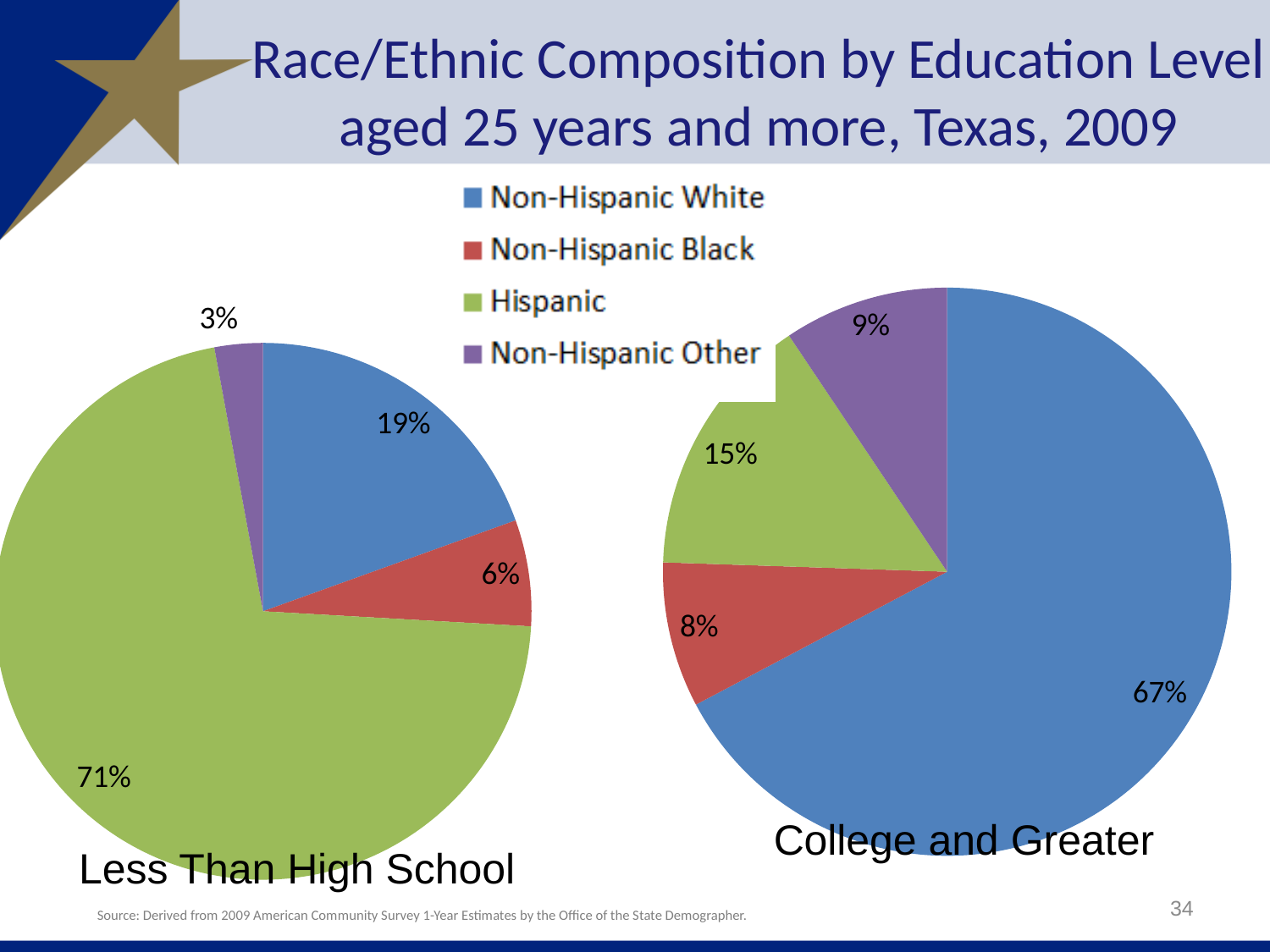
In the Less Than High School pie chart, what share is Hispanic? 71% What is the difference between the Hispanic share in the Less Than High School chart and the Hispanic share in the College and Greater chart? 56 percentage points What kind of charts are shown on the slide? Pie charts In the College and Greater pie chart, what share is Hispanic? 15% In the Less Than High School pie chart, what share is Non-Hispanic White? 19% In the Less Than High School pie chart, which group has the largest share? Hispanic In the College and Greater pie chart, what share is Non-Hispanic Other? 9% In the College and Greater pie chart, what share is Non-Hispanic White? 67% How many series does the legend list? 4 In the College and Greater pie chart, which group has the smallest share? Non-Hispanic Black In the Less Than High School pie chart, which group has the smallest share? Non-Hispanic Other In the College and Greater pie chart, which is larger: the Non-Hispanic Black share or the Hispanic share? Hispanic